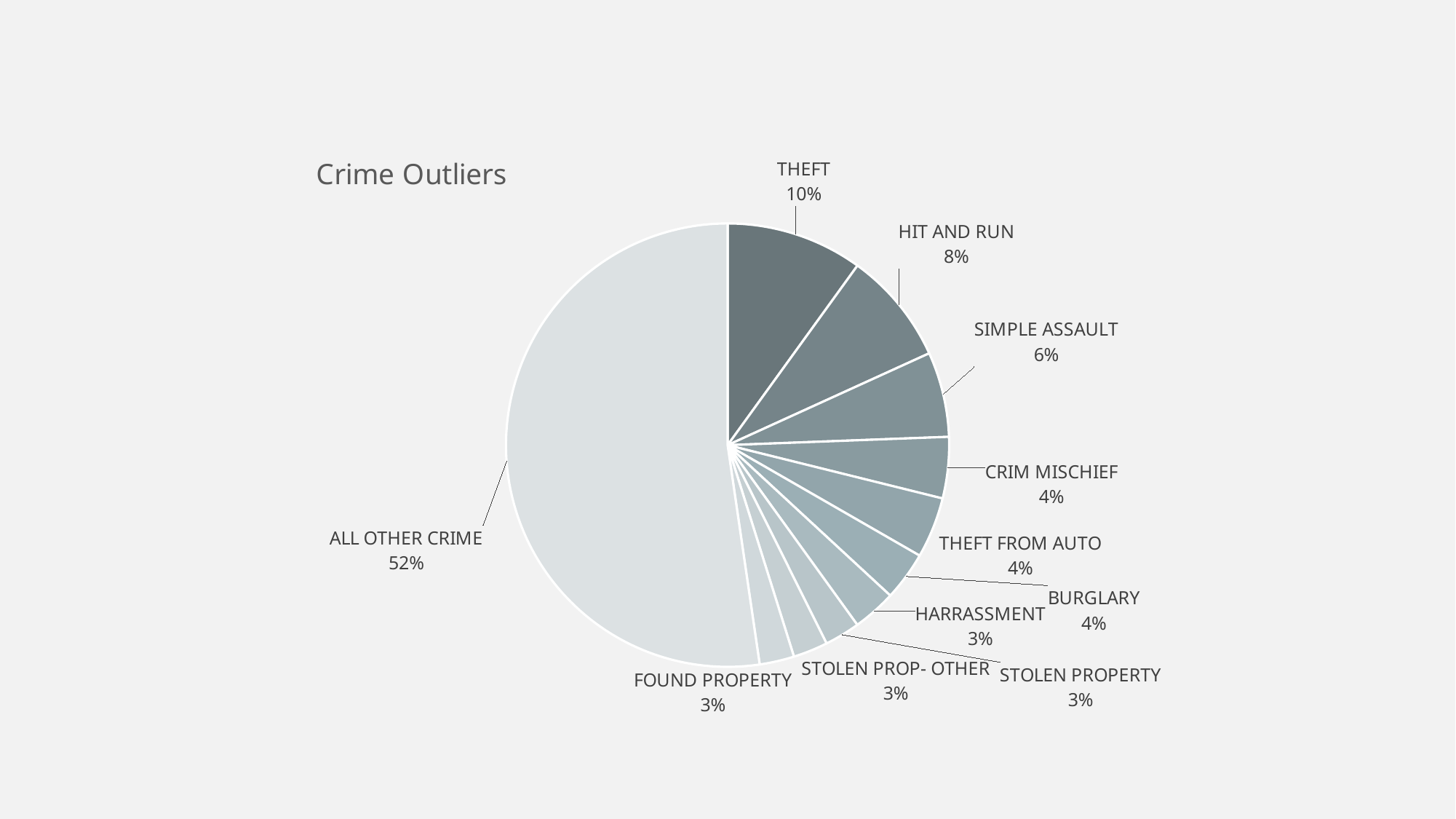
What share of the pie does ALL OTHER CRIME represent? 52% What percentage is shown for SIMPLE ASSAULT? 6% How many slices does the pie chart have? 11 What share of the pie does THEFT represent? 10% What percentage is shown for FOUND PROPERTY? 3% Which is larger, THEFT or HIT AND RUN? THEFT What percentage is shown for HIT AND RUN? 8% What percentage is shown for BURGLARY? 4% What type of chart is shown on the slide? Pie chart What is the difference in percentage points between THEFT and SIMPLE ASSAULT? 4 Which category has the largest slice of the pie? ALL OTHER CRIME What is the title of the chart? Crime Outliers